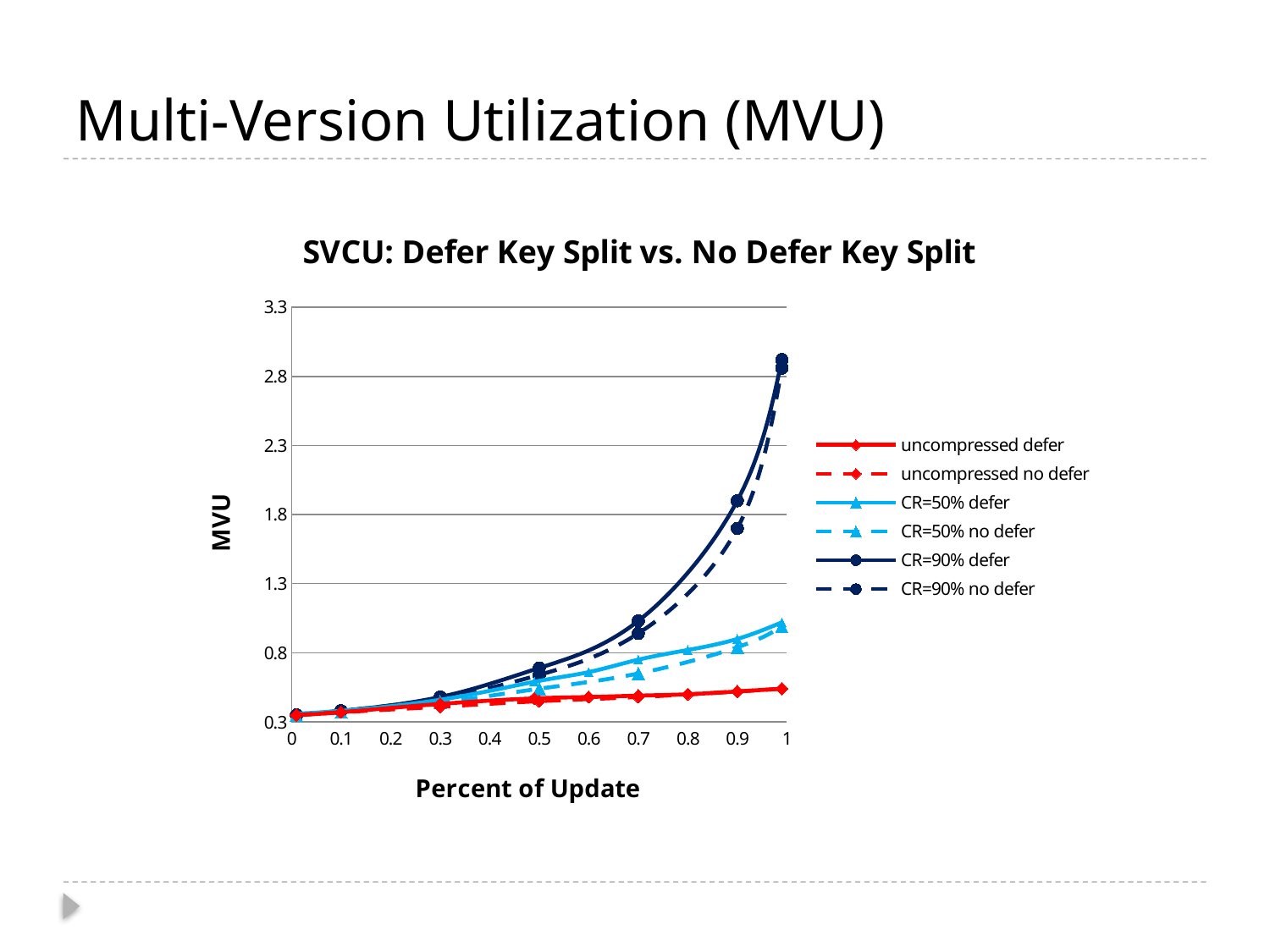
At Percent of Update 1, which is larger: CR=90% defer or uncompressed defer? CR=90% defer What kind of chart is shown on the slide? line chart What is the label of the x axis? Percent of Update At Percent of Update 0.9, which is larger: CR=90% defer or CR=90% no defer? CR=90% defer Does the MVU for CR=90% defer rise or fall as Percent of Update increases? rise Is the value for uncompressed defer at Percent of Update 1 greater or less than 0.8? less How many series does the legend list? 6 What is the title of the chart? SVCU: Defer Key Split vs. No Defer Key Split Is the value for CR=90% defer at Percent of Update 0.9 greater or less than 1.8? greater Is the value for CR=50% defer at Percent of Update 1 greater or less than 0.8? greater